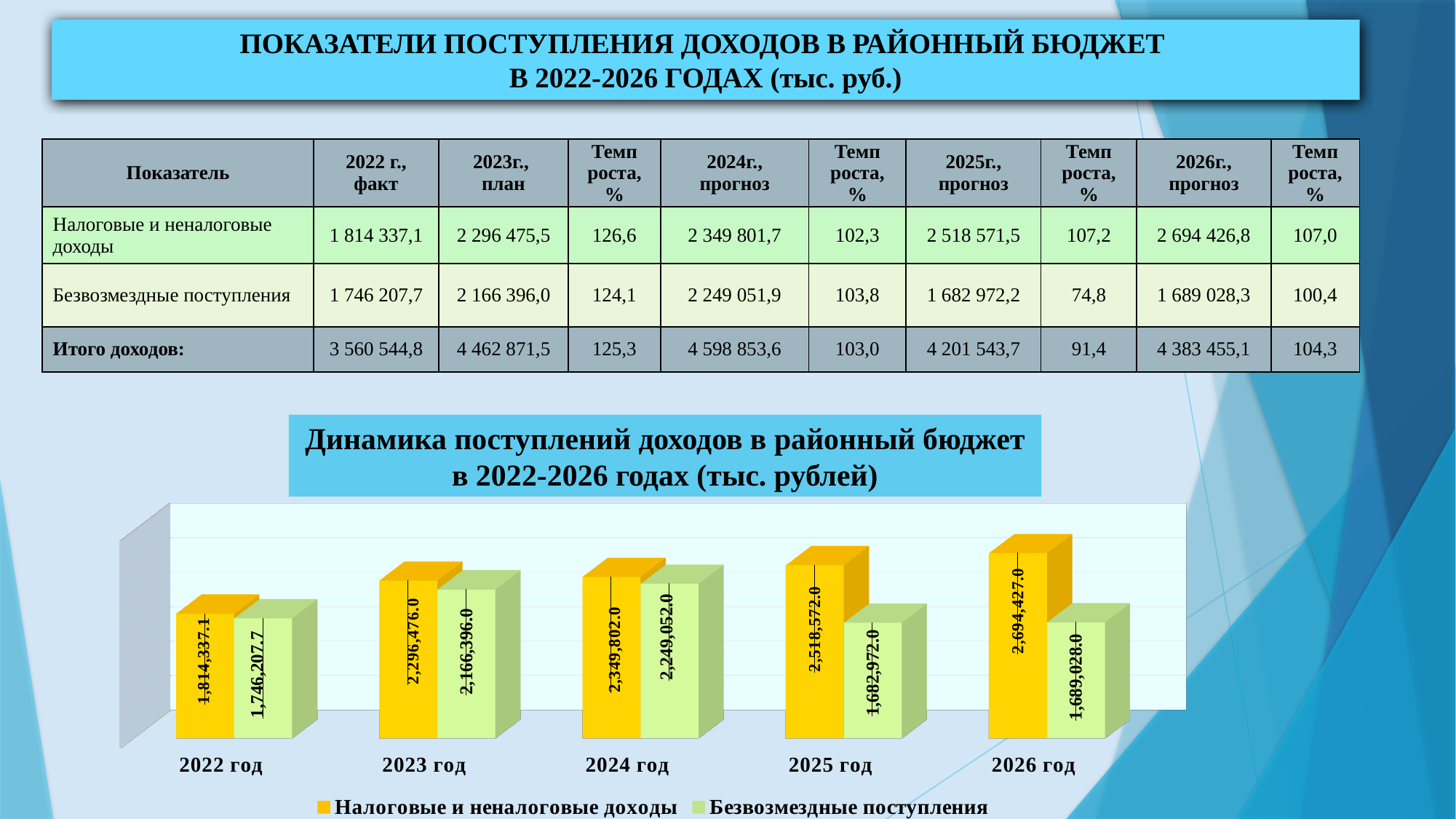
What is the value of Налоговые и неналоговые доходы for 2026 год on the chart? 2,694,427.0 How many series does the chart legend list? 2 In which year is Безвозмездные поступления lowest on the chart? 2025 год What is the difference between Налоговые и неналоговые доходы and Безвозмездные поступления for 2025 год on the chart? 835,600.0 How many year categories are shown on the chart's x axis? 5 What is the value of Безвозмездные поступления for 2025 год on the chart? 1,682,972.0 What is the value of Налоговые и неналоговые доходы for 2022 год on the chart? 1,814,337.1 What type of chart is shown on the slide? bar chart What is the value of Безвозмездные поступления for 2023 год on the chart? 2,166,396.0 Does Налоговые и неналоговые доходы rise or fall from 2022 год to 2026 год on the chart? rise In which year is Налоговые и неналоговые доходы highest on the chart? 2026 год Which is larger for 2024 год on the chart: Налоговые и неналоговые доходы or Безвозмездные поступления? Налоговые и неналоговые доходы